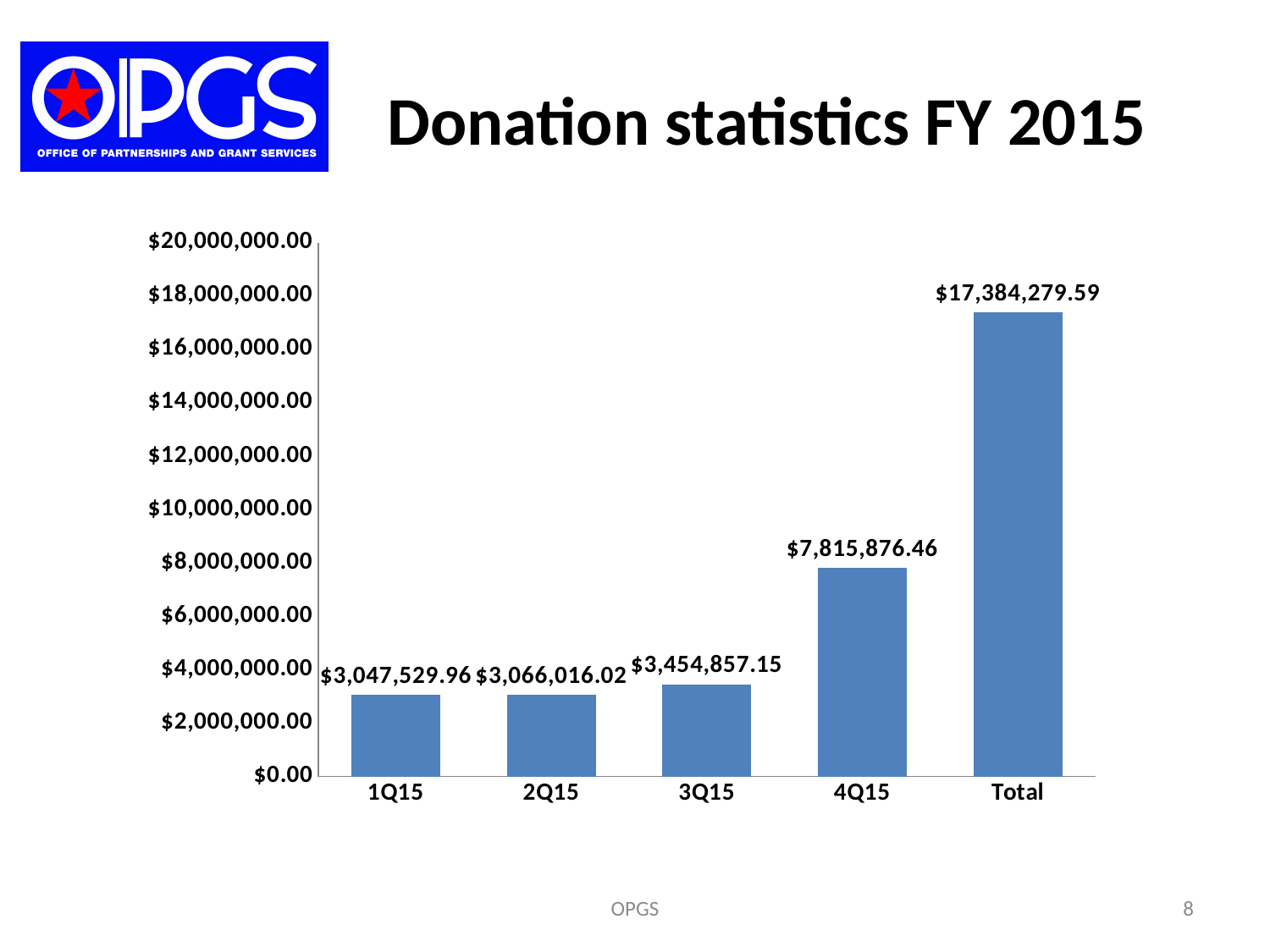
Is the value for 4Q15 greater or less than $8,000,000.00? less What is the difference between the values for 4Q15 and 3Q15? $4,361,019.31 What is the value for 3Q15? $3,454,857.15 What is the value of the Total bar? $17,384,279.59 What kind of chart is shown on the slide? bar chart Which category has the lowest value? 1Q15 Which category has the highest value? Total How many bars are shown in the chart? 5 Which is larger, the value for 3Q15 or the value for 4Q15? 4Q15 Do the values rise or fall from 1Q15 to 4Q15? rise What is the value for 4Q15? $7,815,876.46 What is the value for 1Q15? $3,047,529.96